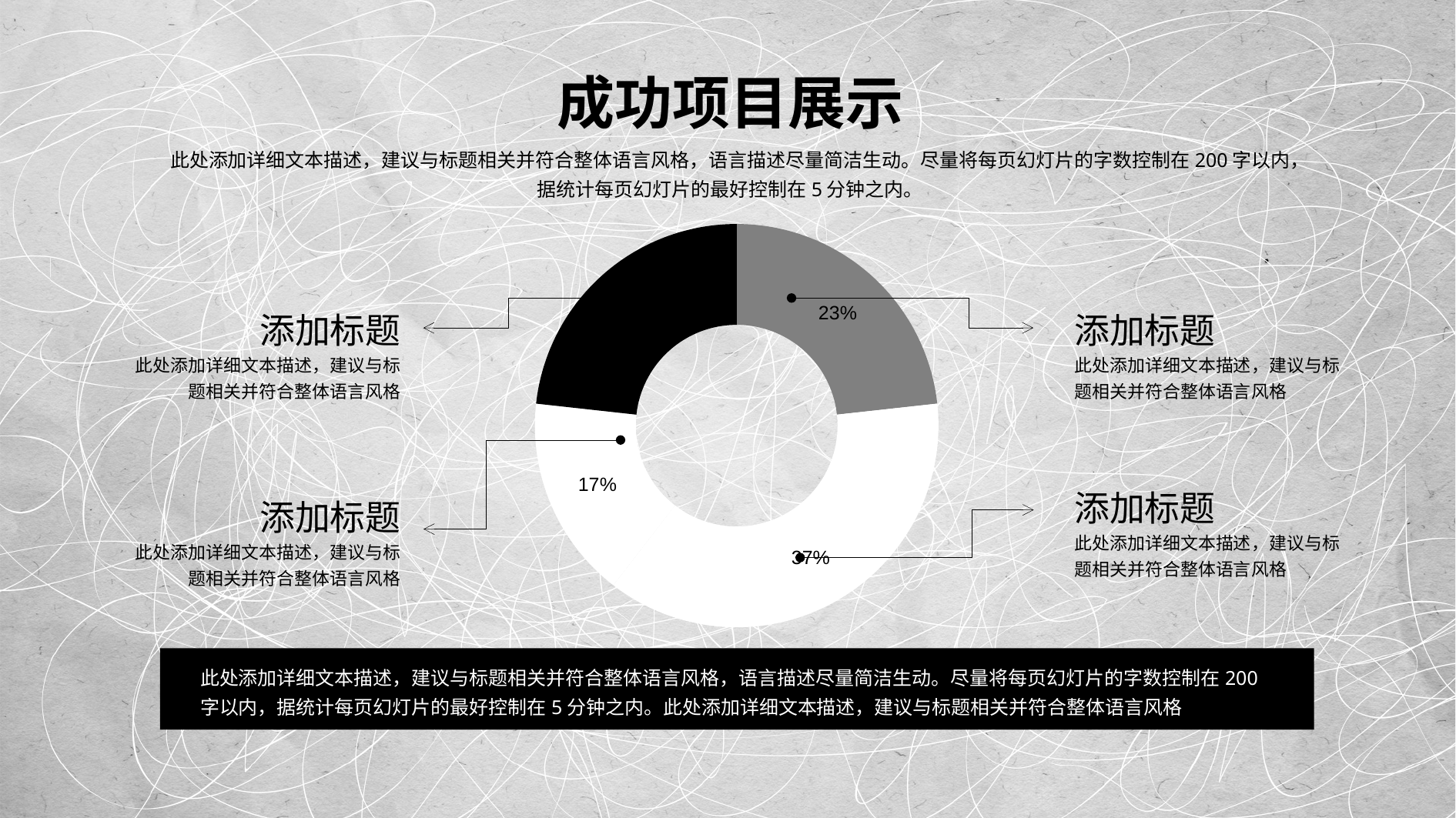
What is the title of the slide containing the chart? 成功项目展示 Which colour slice of the doughnut chart is the largest? white Is the gray slice of the doughnut chart larger or smaller than the white slice? smaller What percentage is labelled on the gray slice of the doughnut chart? 23% How many colours (slice shades) are used in the doughnut chart? 3 What kind of chart is shown on the slide? doughnut (pie) chart